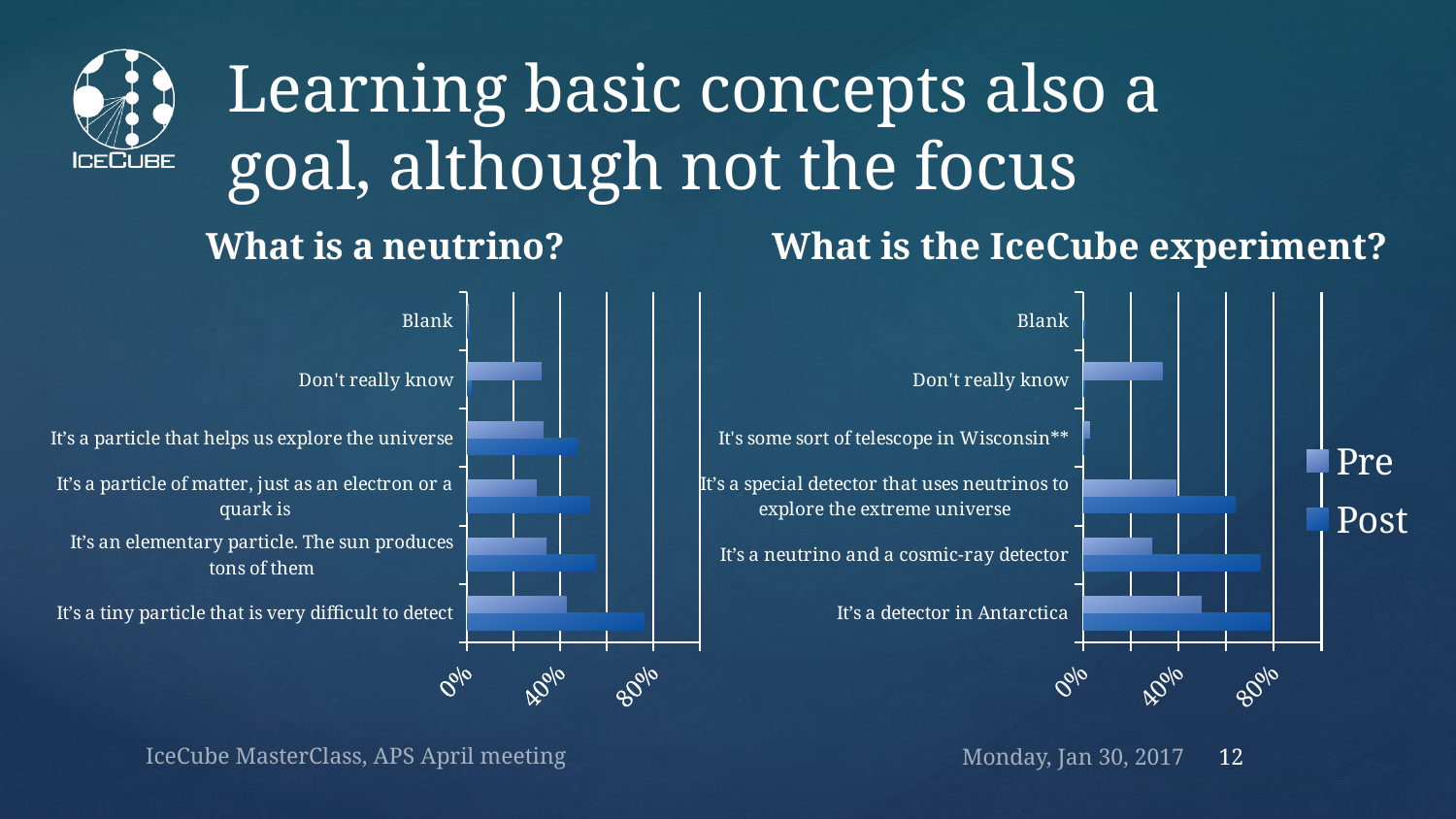
What are the two series names shown in the legend on the slide? Pre and Post In the "What is a neutrino?" chart, is the Post value for "It's a tiny particle that is very difficult to detect" greater or less than 60%? greater How many response categories are shown in the "What is the IceCube experiment?" chart? 6 In the "What is the IceCube experiment?" chart, which category has the highest Pre value? It's a detector in Antarctica In the "What is a neutrino?" chart, which category has the highest Post value? It's a tiny particle that is very difficult to detect How many series does the legend list for the charts on the slide? 2 In the "What is a neutrino?" chart, which is larger for "It's a tiny particle that is very difficult to detect": the Pre value or the Post value? Post In the "What is the IceCube experiment?" chart, is the Post value for "It's a detector in Antarctica" greater or less than 60%? greater How many response categories are shown in the "What is a neutrino?" chart? 6 In the "What is the IceCube experiment?" chart, which is larger for "Don't really know": the Pre value or the Post value? Pre In the "What is a neutrino?" chart, is the Pre value for "Don't really know" greater or less than 40%? less What kind of chart is the "What is a neutrino?" chart? bar chart